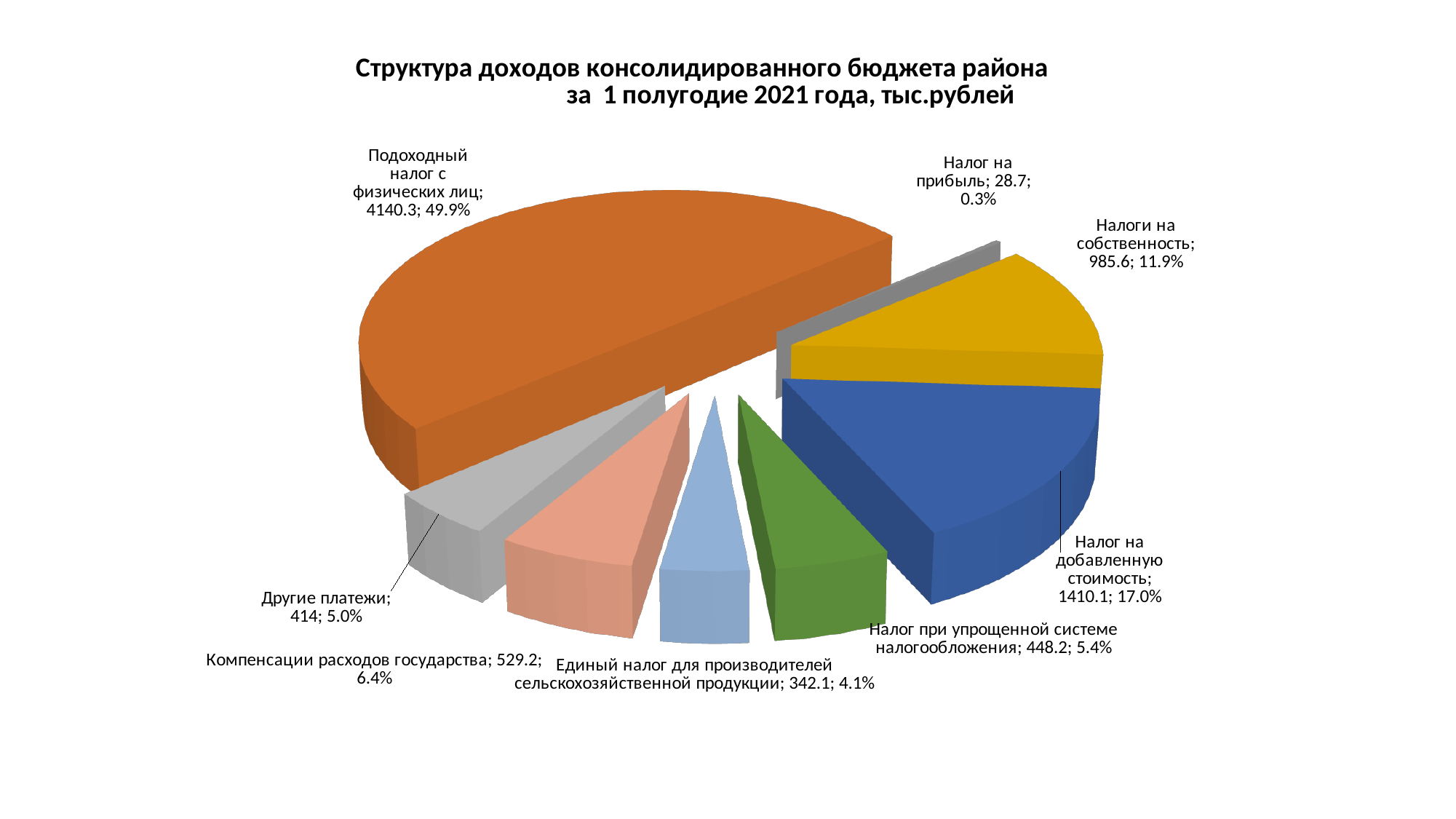
What is the value for Налог на добавленную стоимость? 1410.1 What is the value for Подоходный налог с физических лиц? 4140.3 What kind of chart is shown on the slide? pie chart Which is larger, the value for Другие платежи or the value for Налог при упрощенной системе налогообложения? Налог при упрощенной системе налогообложения What is the value for Компенсации расходов государства? 529.2 Which category has the largest slice? Подоходный налог с физических лиц What is the difference between the values for Налог на добавленную стоимость and Налоги на собственность? 424.5 What share of the pie does Единый налог для производителей сельскохозяйственной продукции take? 4.1% How many slices does the pie chart have? 8 Which category has the smallest slice? Налог на прибыль What share of the pie does Налог при упрощенной системе налогообложения take? 5.4% What is the value for Налоги на собственность? 985.6